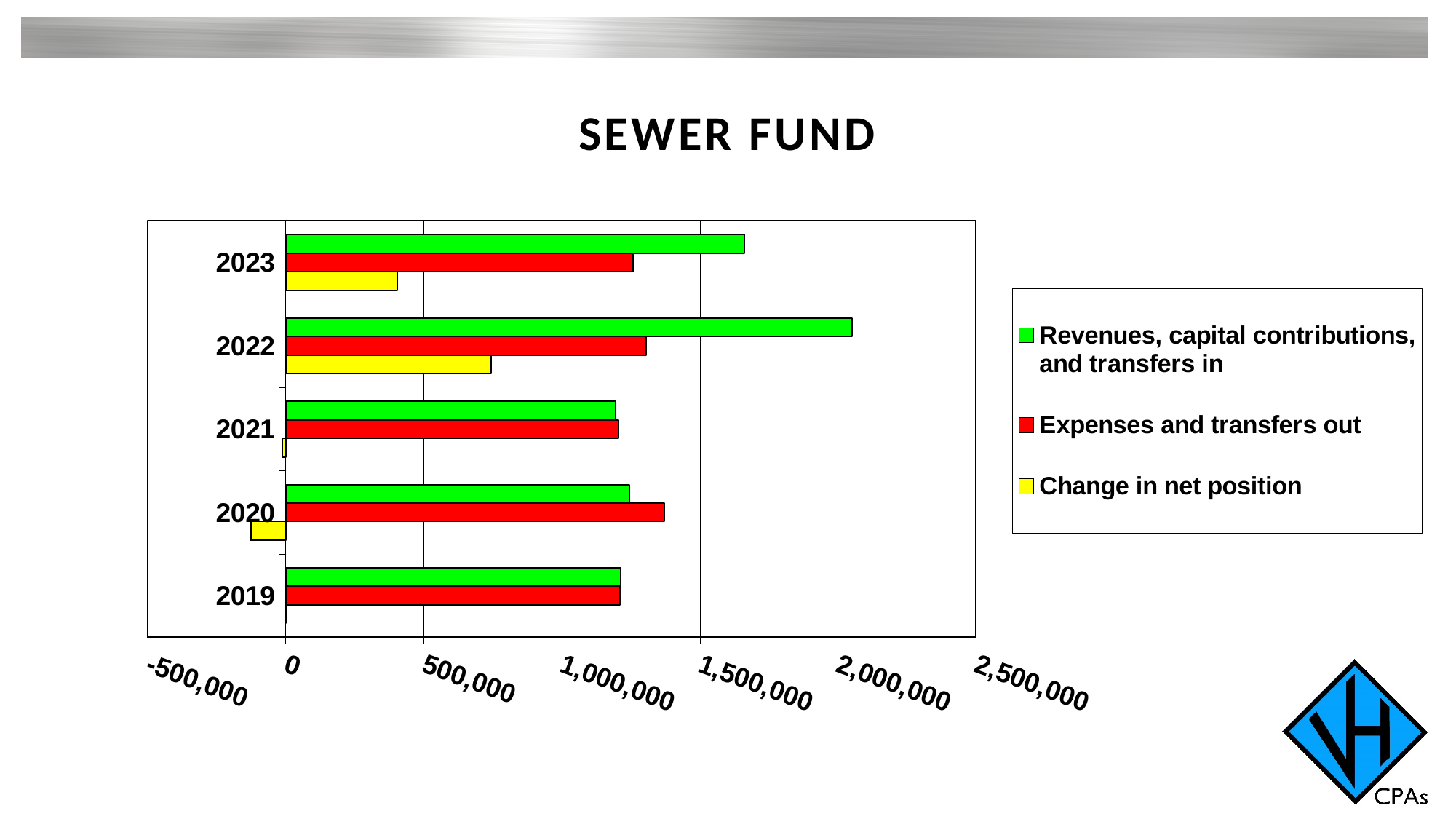
In 2020, which is larger: Revenues, capital contributions, and transfers in or Expenses and transfers out? Expenses and transfers out How many years are shown on the chart? 5 Which colour represents Change in net position in the legend? yellow What is the title of the chart? SEWER FUND Is the value for Change in net position for 2023 greater or less than 500,000? less Which year has the highest value for Revenues, capital contributions, and transfers in? 2022 Which year has the highest value for Change in net position? 2022 What kind of chart is shown on the slide? bar chart Is the value for Revenues, capital contributions, and transfers in for 2022 greater or less than 2,000,000? greater How many series does the legend list? 3 Which year has the lowest value for Change in net position? 2020 Is the value for Expenses and transfers out for 2020 greater or less than 1,000,000? greater